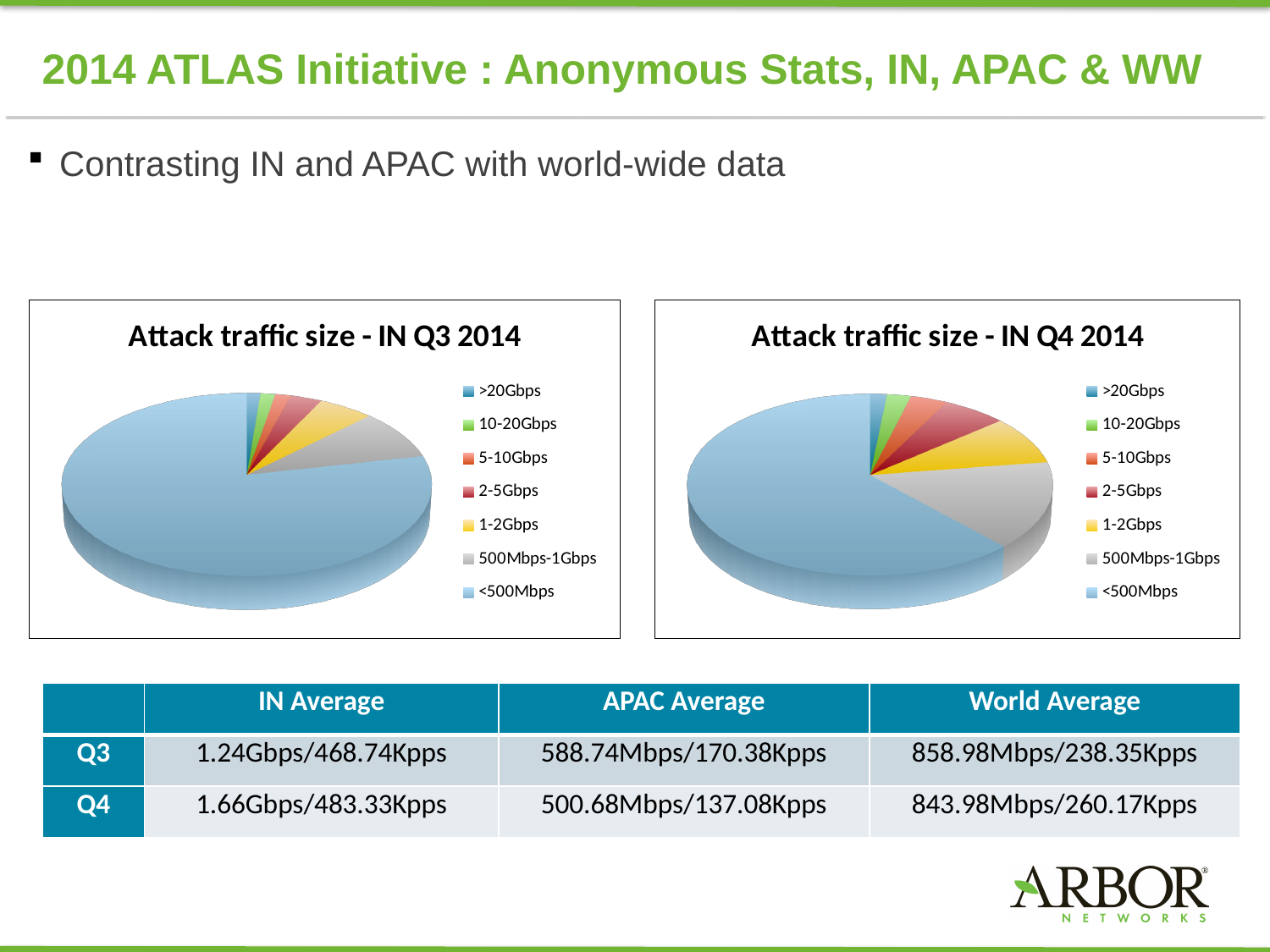
In the 'Attack traffic size - IN Q3 2014' chart, which slice is larger: <500Mbps or 1-2Gbps? <500Mbps What is the title of the pie chart on the left of the slide? Attack traffic size - IN Q3 2014 In the 'Attack traffic size - IN Q3 2014' chart, which category has the largest slice? <500Mbps In the 'Attack traffic size - IN Q4 2014' chart, how many categories does the legend list? 7 In the 'Attack traffic size - IN Q4 2014' chart, what is the first category listed in the legend? >20Gbps What kind of chart is the 'Attack traffic size - IN Q3 2014' chart? pie chart Which chart shows a larger share for <500Mbps: the Q3 2014 chart or the Q4 2014 chart? Q3 2014 In the 'Attack traffic size - IN Q4 2014' chart, which category has the largest slice? <500Mbps What kind of chart is the 'Attack traffic size - IN Q4 2014' chart? pie chart In the 'Attack traffic size - IN Q3 2014' chart, how many categories does the legend list? 7 In the 'Attack traffic size - IN Q4 2014' chart, which slice is larger: 500Mbps-1Gbps or 10-20Gbps? 500Mbps-1Gbps